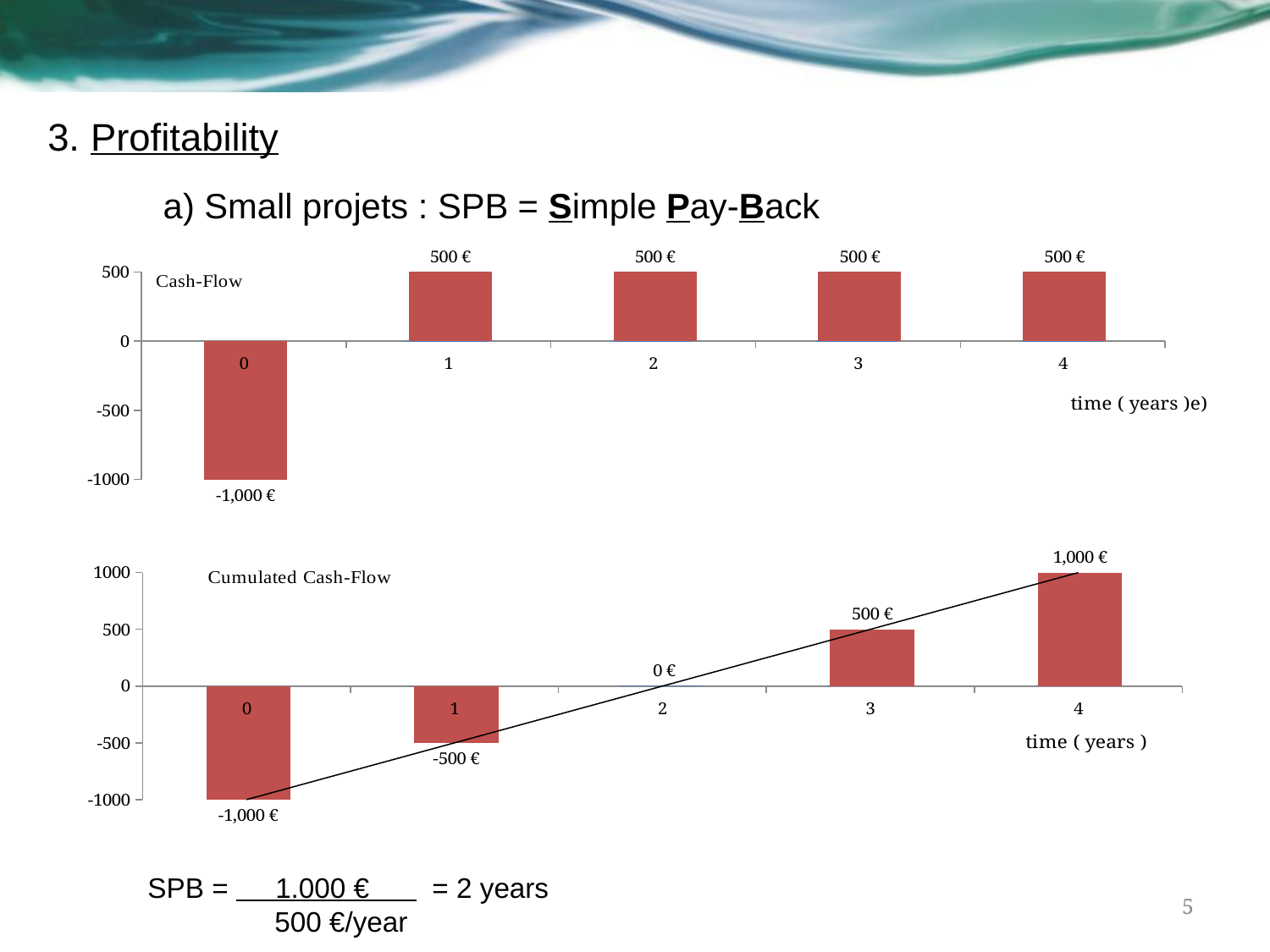
In the Cash-Flow chart, is the value for year 1 larger or smaller than the value for year 0? larger In the Cumulated Cash-Flow chart, what is the value for year 4? 1,000 € In the Cumulated Cash-Flow chart, what is the value for year 1? -500 € In the Cumulated Cash-Flow chart, what is the difference between the values for year 4 and year 3? 500 € In the Cumulated Cash-Flow chart, which year has the highest value? 4 What type of chart is the Cumulated Cash-Flow chart? bar chart In the Cash-Flow chart, what is the value for year 3? 500 € In the Cumulated Cash-Flow chart, what is the value for year 2? 0 € In the Cumulated Cash-Flow chart, do the values rise or fall from year 0 to year 4? rise In the Cash-Flow chart, what is the value for year 0? -1,000 € In the Cumulated Cash-Flow chart, which year has the lowest value? 0 How many years (categories) are plotted in the Cash-Flow chart? 5